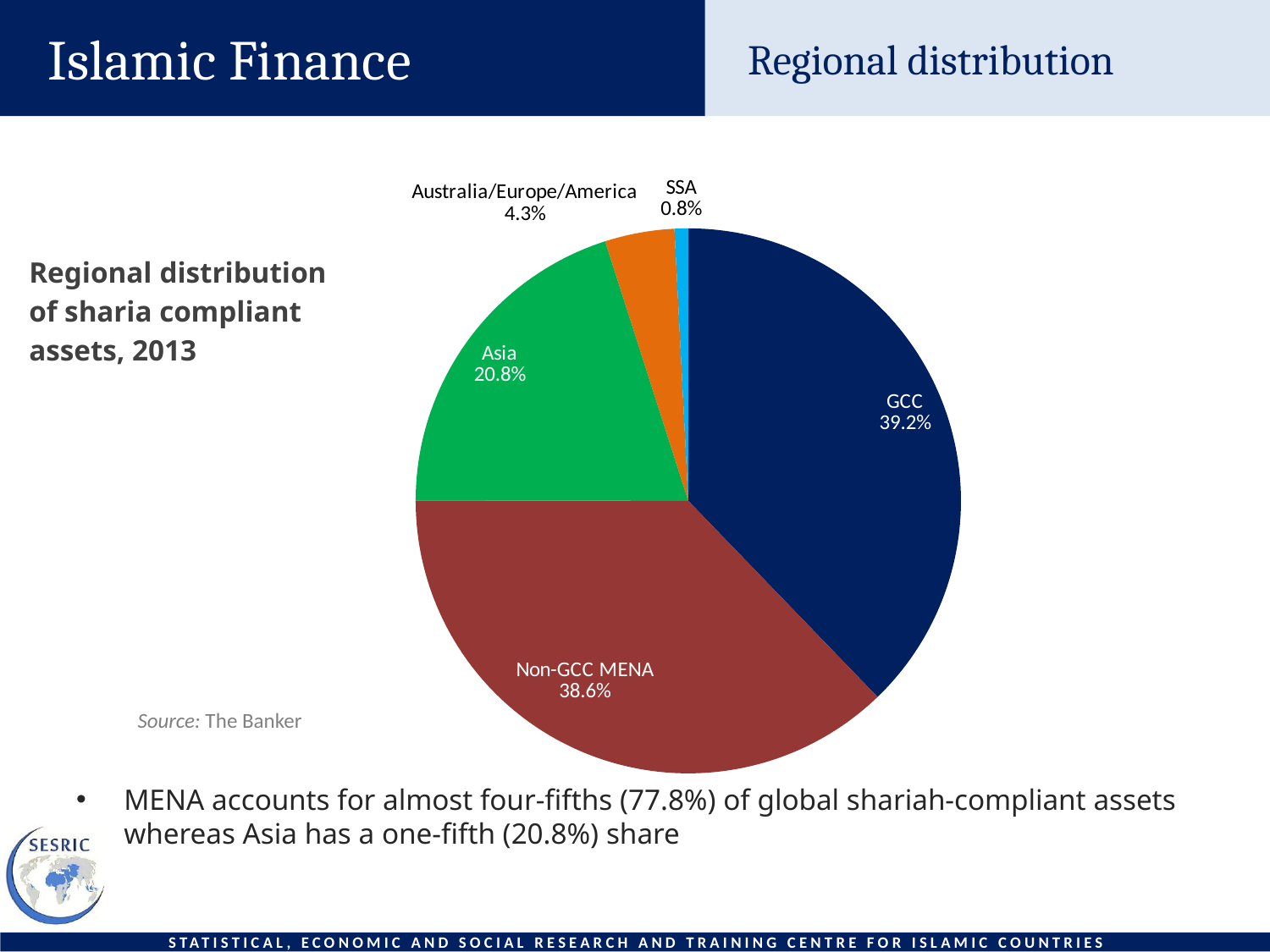
What share of sharia compliant assets does Australia/Europe/America hold? 4.3% What is the difference in percentage points between the Australia/Europe/America share and the SSA share? 3.5 What share of sharia compliant assets does SSA hold? 0.8% What type of chart is used to show the regional distribution of sharia compliant assets? Pie chart How many regions are shown in the pie chart? 5 What share of sharia compliant assets does GCC hold? 39.2% Which region has the smallest share of sharia compliant assets? SSA What share of sharia compliant assets does Non-GCC MENA hold? 38.6% Which has a larger share, Asia or Australia/Europe/America? Asia What is the difference in percentage points between the GCC share and the Asia share? 18.4 Which region has the largest share of sharia compliant assets? GCC What share of sharia compliant assets does Asia hold? 20.8%